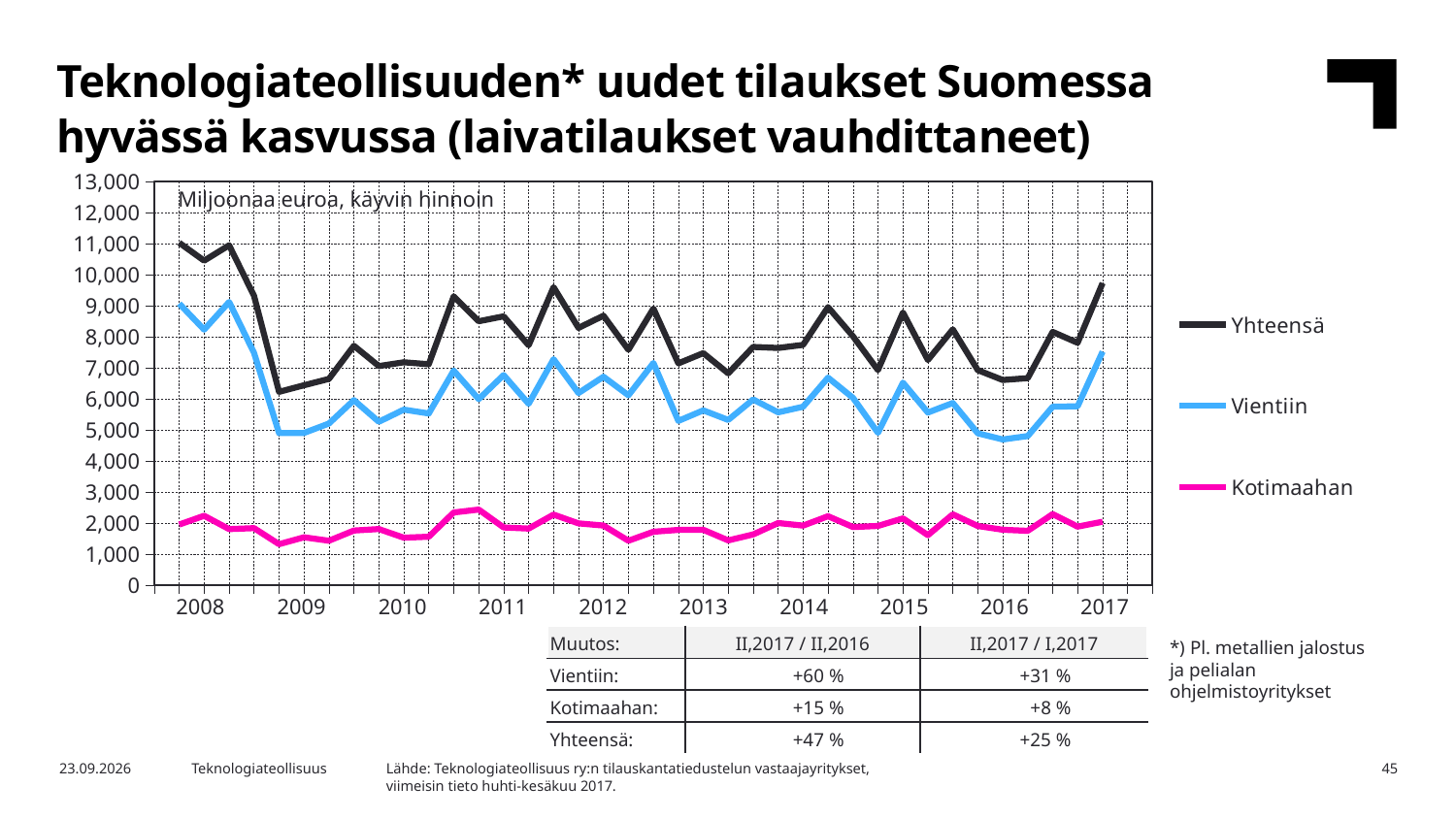
Is the value for Yhteensä at the last point in 2017 greater or less than 9,000? greater What kind of chart is shown on the slide? Line chart Which is larger at the start of 2008, Vientiin or Kotimaahan? Vientiin Which series is plotted with the highest values throughout the chart? Yhteensä Does the Yhteensä line rise or fall from the start of 2008 to the start of 2009? Fall What unit label is printed inside the chart area? Miljoonaa euroa, käyvin hinnoin Is the value for Yhteensä at the start of 2008 greater or less than 10,000? greater How many series does the legend list? 3 How many year labels are shown on the x axis? 10 Which series is plotted with the lowest values throughout the chart? Kotimaahan Is the value for Kotimaahan at the start of 2008 greater or less than 3,000? less